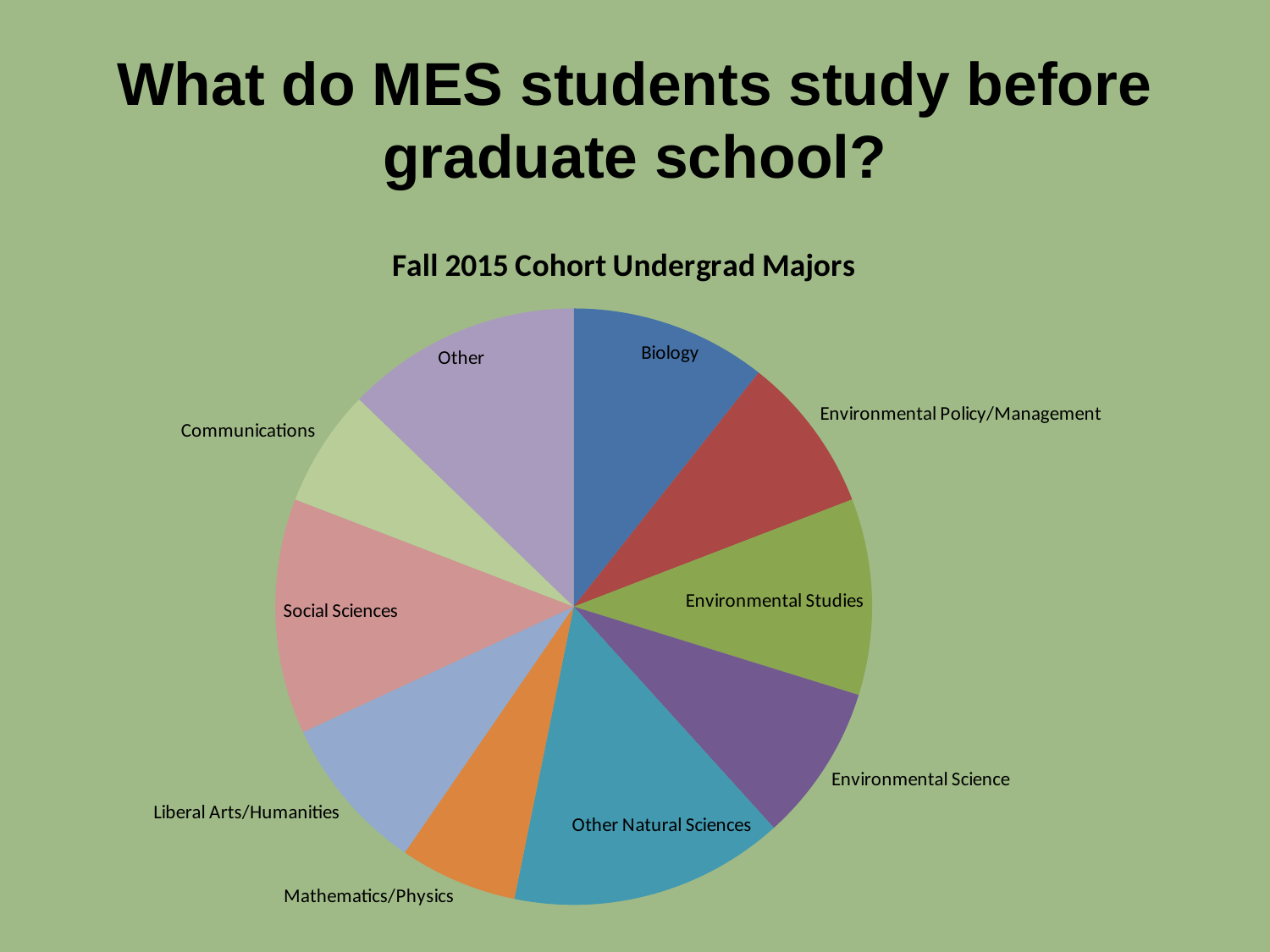
Which slice is larger, Biology or Mathematics/Physics? Biology How many slices does the pie chart have? 10 What colour is the Mathematics/Physics slice? orange Which slice is larger, Social Sciences or Communications? Social Sciences Which slice is larger, Other or Environmental Science? Other Which undergraduate major has the largest slice of the pie? Other Natural Sciences What kind of chart is shown on the slide? pie chart What is the title of the chart? Fall 2015 Cohort Undergrad Majors